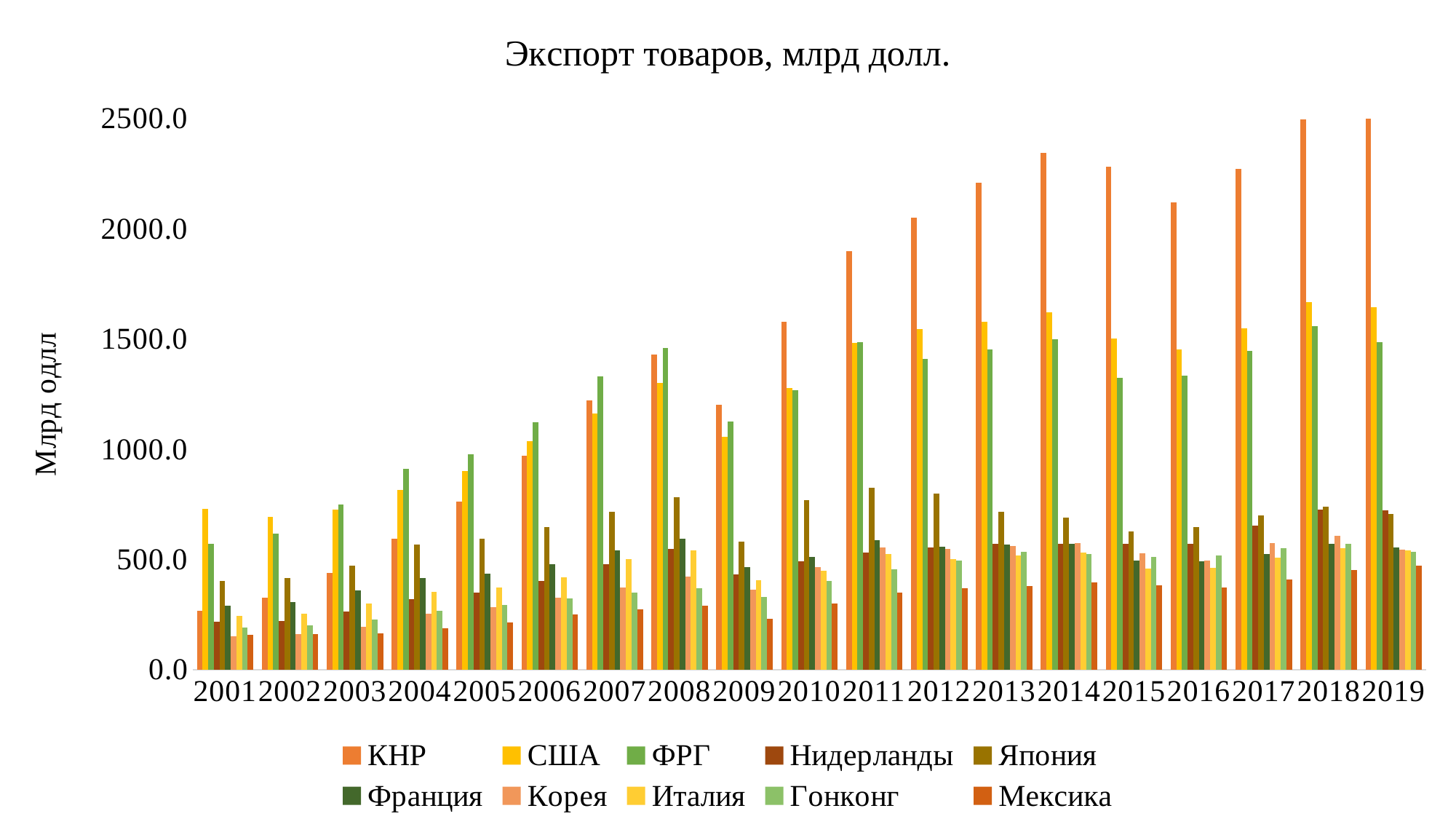
Which is larger in 2001, the value for КНР or the value for США? США Do the values for КНР generally rise or fall from 2001 to 2019? rise Which series has the highest value in 2001? США What kind of chart is shown on the slide? Bar chart Which series has the highest value in 2019? КНР Is the value for Япония in 2011 greater or less than 500? greater Is the value for США in 2018 greater or less than 1500? greater How many years are shown along the x axis? 19 Is the value for КНР in 2001 greater or less than 500? less What is the title of the chart? Экспорт товаров, млрд долл. How many series does the legend list? 10